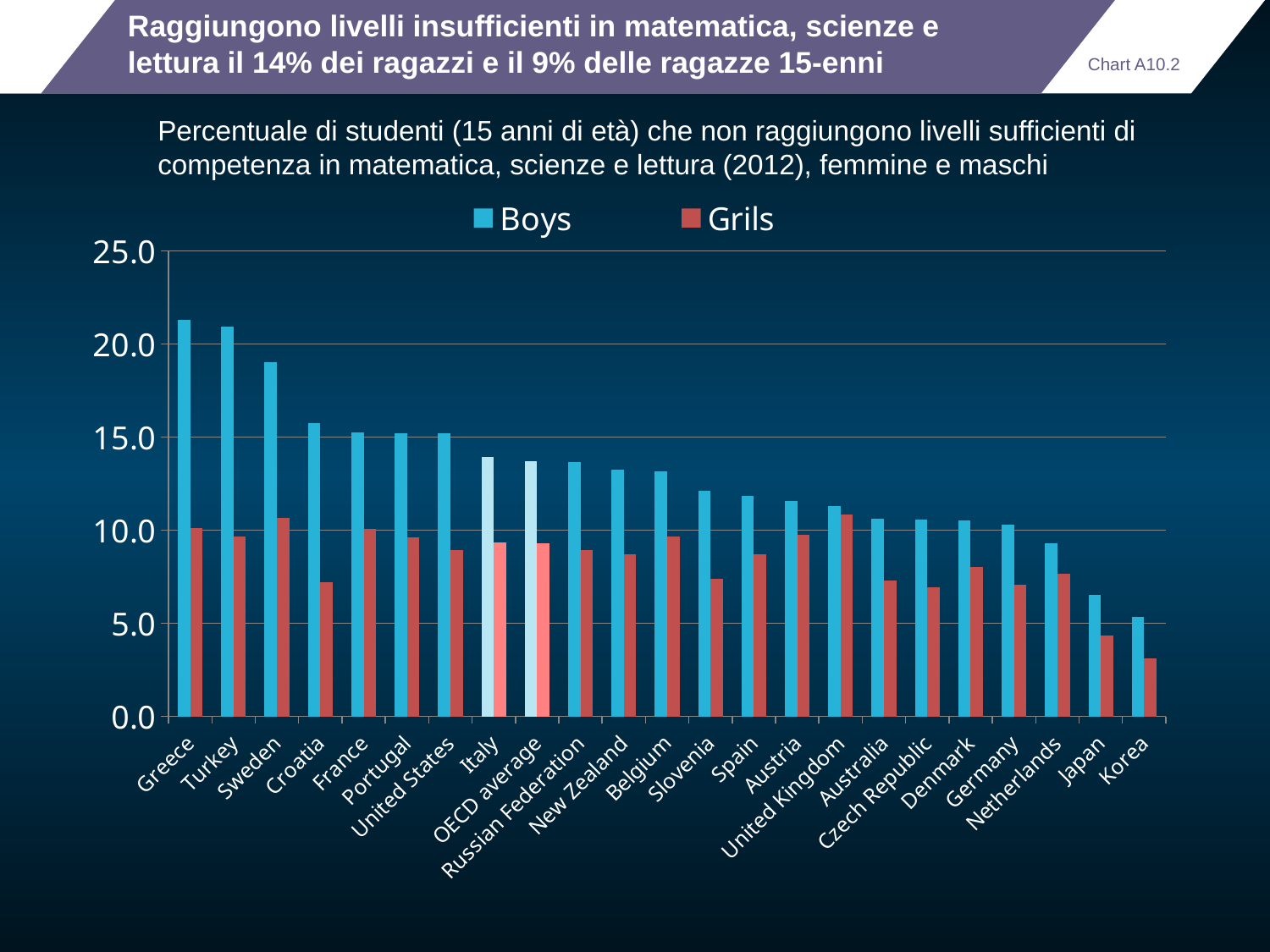
Is the Boys value for Italy greater or less than 15.0? less Which category has the lowest value for Grils? Korea Is the Grils value for Japan greater or less than 5.0? less How many countries/categories are shown along the x axis? 23 Is the Boys value for Sweden greater or less than 15.0? greater Which colour represents the Boys series in the legend? blue How many series does the legend list? 2 Which category has the lowest value for Boys? Korea Which is larger for Greece, the Boys value or the Grils value? Boys Do the Boys values generally rise or fall from left to right along the x axis? fall What kind of chart is shown on the slide? bar chart